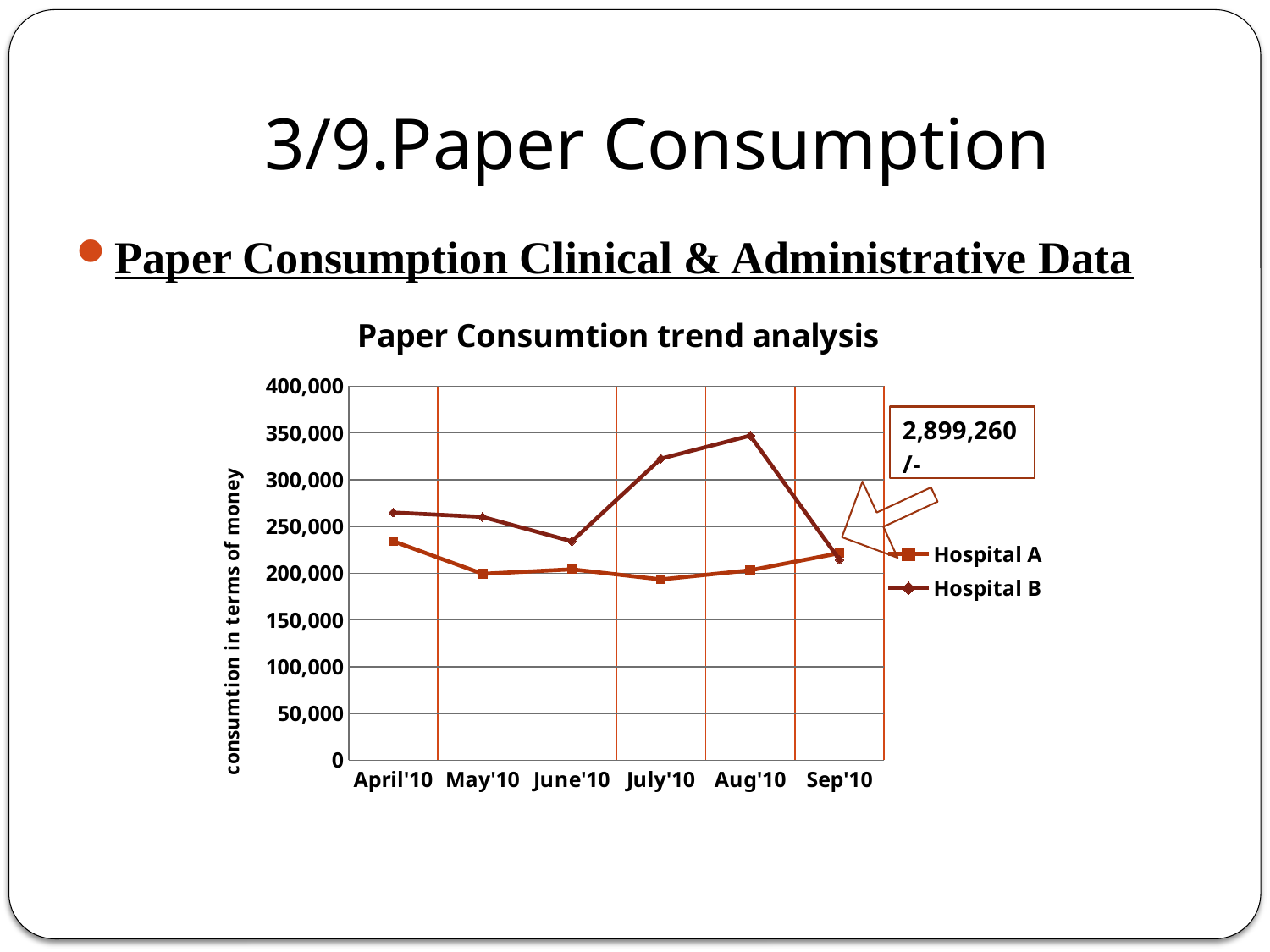
Is the value for Hospital A in May'10 greater or less than 250,000? less In which month does Hospital A have its highest paper consumption? April'10 Does Hospital B's paper consumption rise or fall from Aug'10 to Sep'10? fall In which month does Hospital B reach its highest paper consumption? Aug'10 Is the value for Hospital B in April'10 greater or less than 250,000? greater What kind of chart is shown on the slide? line chart How many series does the legend list? 2 How many months are plotted along the x axis? 6 What is the title of the chart? Paper Consumtion trend analysis Is the value for Hospital B in Aug'10 greater or less than 300,000? greater In which month is Hospital B's paper consumption lowest? Sep'10 In Aug'10, which hospital has the higher paper consumption, Hospital A or Hospital B? Hospital B